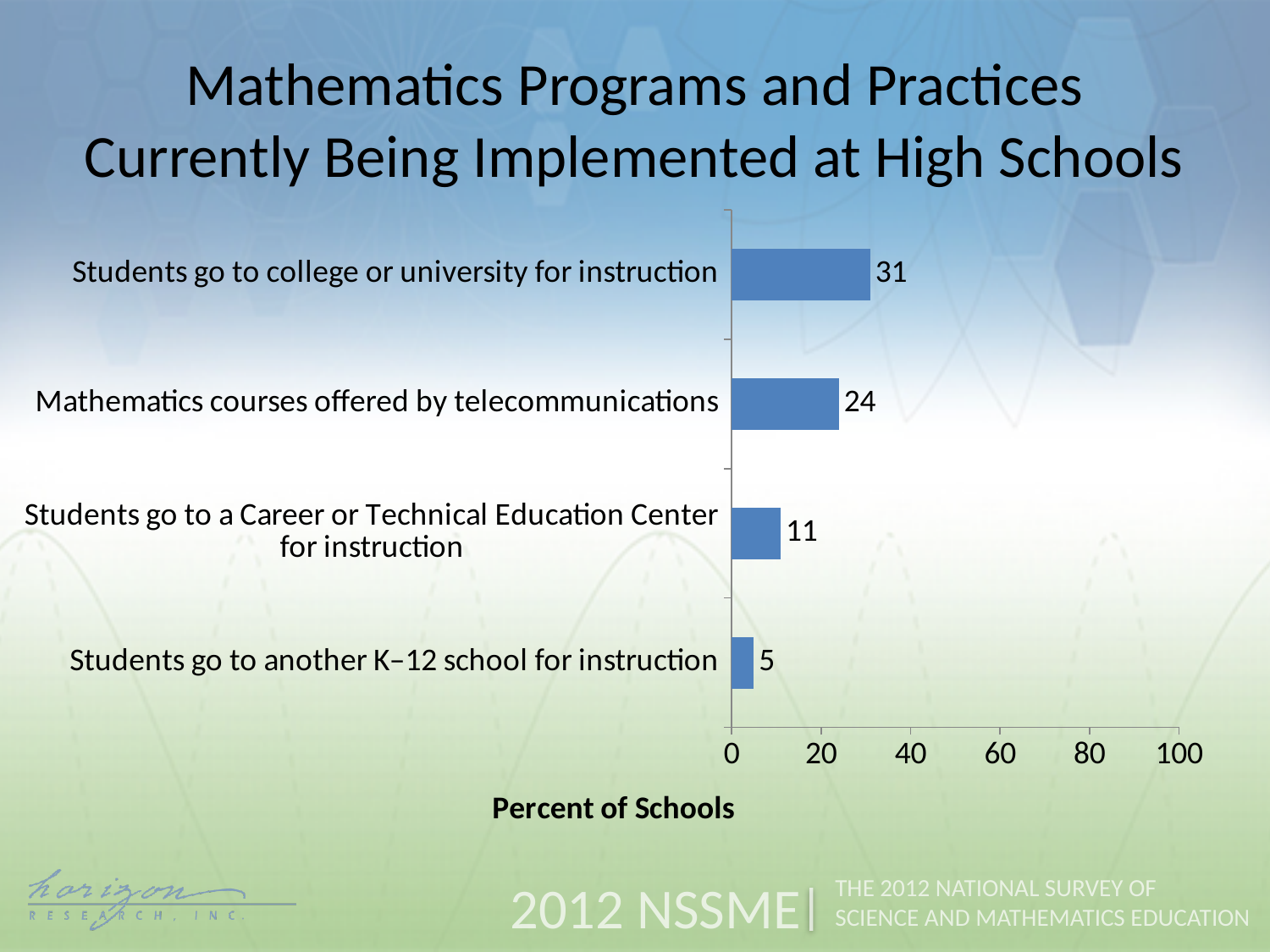
What percent of schools offer mathematics courses by telecommunications? 24 Is the value for students going to college or university for instruction greater or less than 40? less How many programs or practices are shown in the chart? 4 What percent of schools have students go to a Career or Technical Education Center for instruction? 11 Which program or practice has the lowest percent of schools? Students go to another K–12 school for instruction What percent of schools have students go to college or university for instruction? 31 What is the difference in percent of schools between students going to college or university for instruction and mathematics courses offered by telecommunications? 7 Which program or practice has the highest percent of schools? Students go to college or university for instruction Which is larger: the percent of schools where students go to a Career or Technical Education Center for instruction, or where students go to another K–12 school for instruction? Students go to a Career or Technical Education Center for instruction What is the label of the horizontal axis? Percent of Schools What percent of schools have students go to another K–12 school for instruction? 5 What kind of chart is shown on the slide? Bar chart